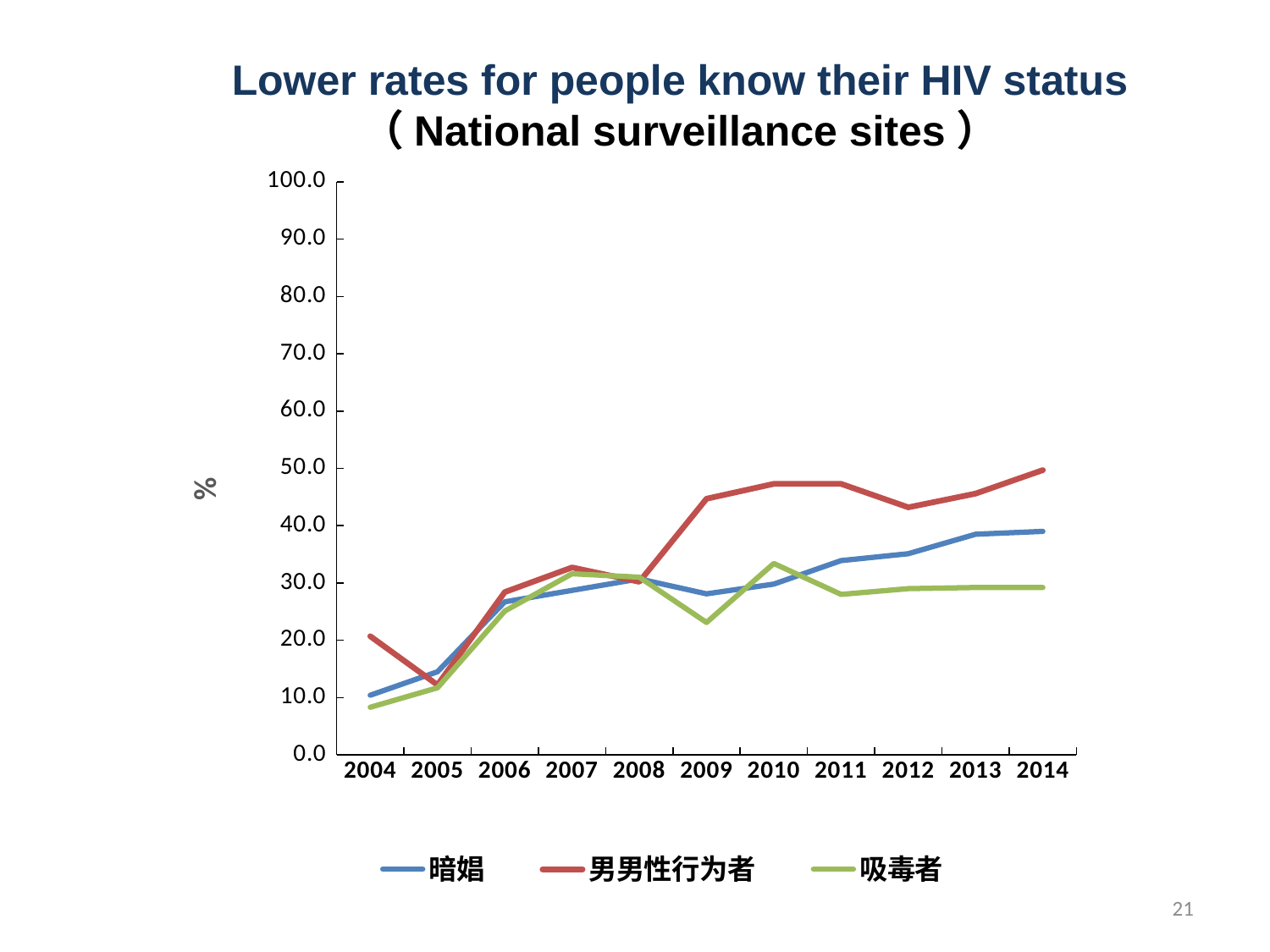
Is the value for 男男性行为者 in 2009 greater or less than 40.0? greater Does the 暗娼 line rise or fall from 2009 to 2014? rise Is the value for 暗娼 in 2004 greater or less than 20.0? less How many years are plotted along the x axis? 11 How many series does the legend list? 3 Which series has the highest value in 2012? 男男性行为者 In 2014, which series has the higher value, 男男性行为者 or 暗娼? 男男性行为者 What kind of chart is shown on the slide? line chart What is the label on the y axis? % Is the value for 男男性行为者 in 2014 greater or less than 40.0? greater In 2009, which series has the higher value, 暗娼 or 吸毒者? 暗娼